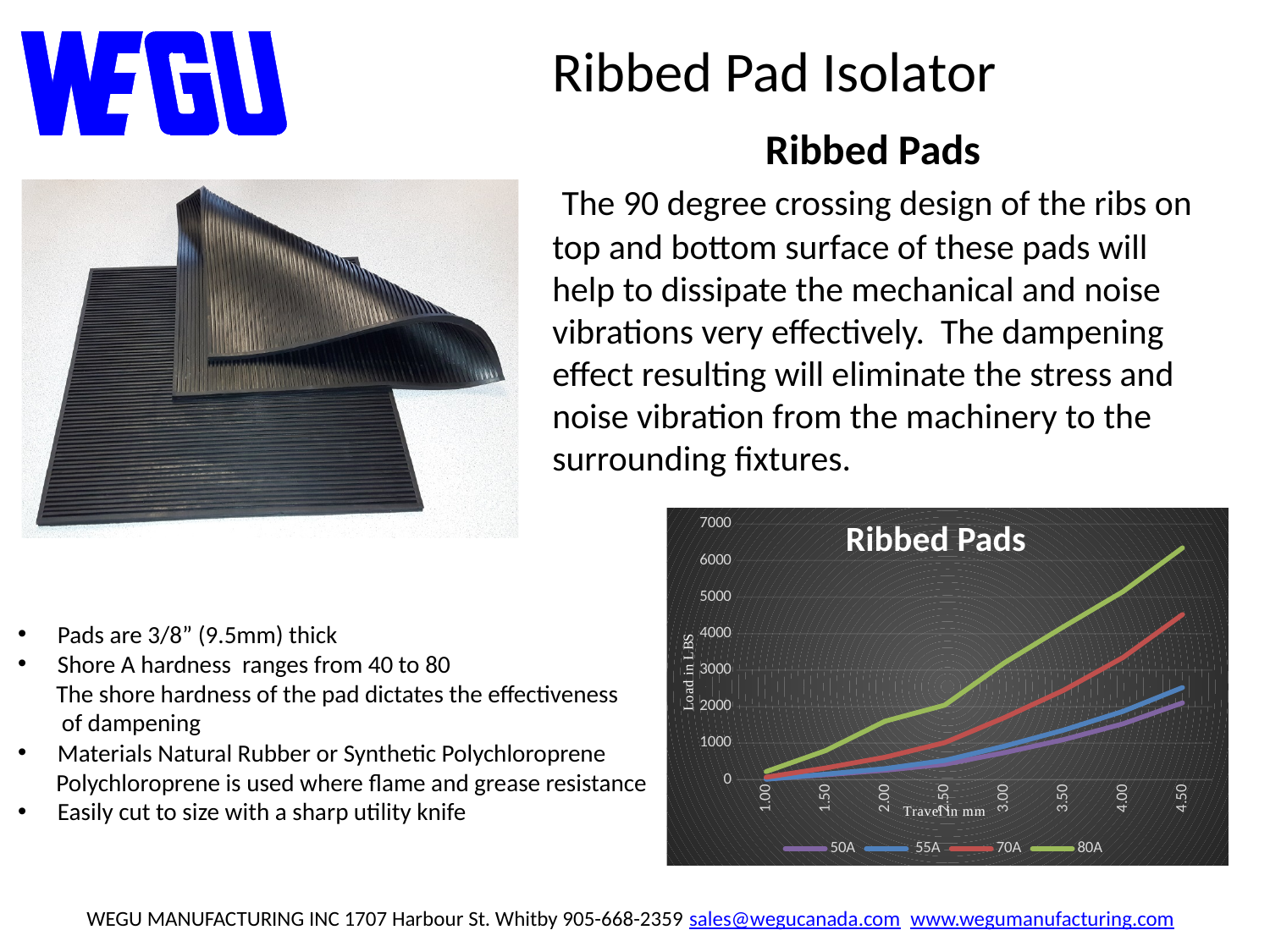
What kind of chart is shown on the slide? line chart At 4.50 mm of travel, which series has the larger load, 70A or 55A? 70A Is the load for the 70A series at 4.50 mm greater or less than 4000? greater How many series does the legend of the chart list? 4 What is the title of the chart? Ribbed Pads What is the label of the y axis of the chart? Load in LBS Does the load for the 80A series rise or fall as travel increases? rise Is the load for the 70A series at 3.00 mm greater or less than 1000? greater Which series has the lowest load at 4.50 mm of travel? 50A Which series reaches the highest load at 4.50 mm of travel? 80A Is the load for the 80A series at 4.50 mm greater or less than 6000? greater